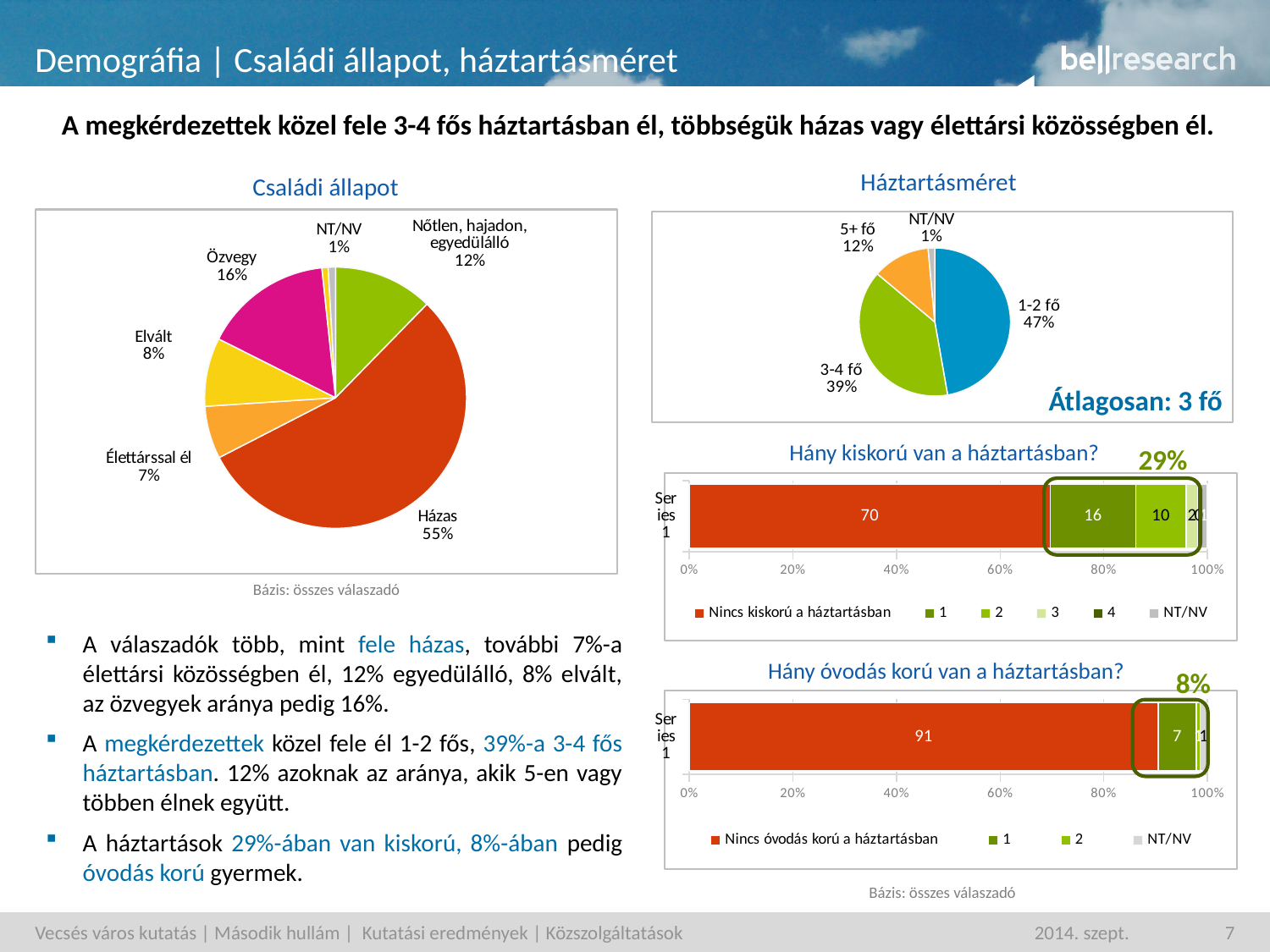
In the 'Háztartásméret' pie chart, which is larger: '1-2 fő' or '5+ fő'? 1-2 fő In the 'Hány kiskorú van a háztartásban?' chart, what value is shown for 'Nincs kiskorú a háztartásban'? 70 In the 'Háztartásméret' pie chart, which category has the smallest share? NT/NV How many series does the legend of the 'Hány kiskorú van a háztartásban?' chart list? 6 In the 'Családi állapot' pie chart, what is the difference between the 'Özvegy' and 'Elvált' shares? 8% In the 'Háztartásméret' pie chart, what percentage is shown for '3-4 fő'? 39% In the 'Hány óvodás korú van a háztartásban?' chart, what value is shown for the series '1'? 7 In the 'Családi állapot' pie chart, which category has the largest share? Házas In the 'Családi állapot' pie chart, what percentage is shown for 'Házas'? 55% How many slices does the 'Családi állapot' pie chart have? 7 How many slices does the 'Háztartásméret' pie chart have? 4 What kind of chart is 'Hány óvodás korú van a háztartásban?'? Stacked bar chart